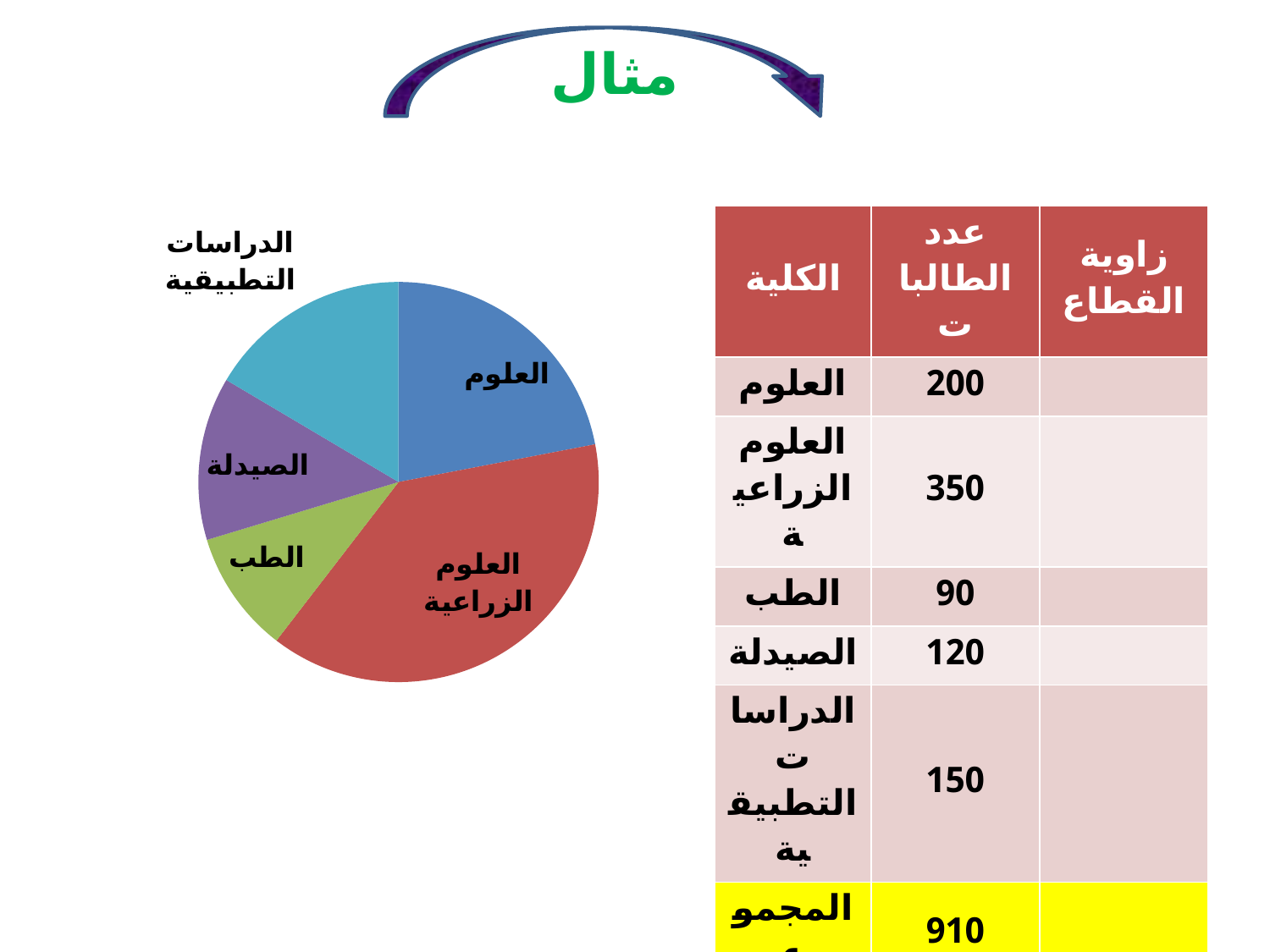
What is the total number of students shown in the table (المجموع)? 910 Which college has the largest slice in the pie chart? العلوم الزراعية Which slice is larger in the pie chart, العلوم or الدراسات التطبيقية? العلوم What colour is the العلوم slice in the pie chart? blue According to the table on the slide, how many students does الدراسات التطبيقية have? 150 Which slice is larger in the pie chart, الصيدلة or الطب? الصيدلة According to the table on the slide, how many students does الصيدلة have? 120 According to the table on the slide, how many students does العلوم الزراعية have? 350 What kind of chart is shown on the slide? pie chart What is the difference in student numbers between العلوم الزراعية and العلوم? 150 How many slices does the pie chart have? 5 Which college has the smallest slice in the pie chart? الطب